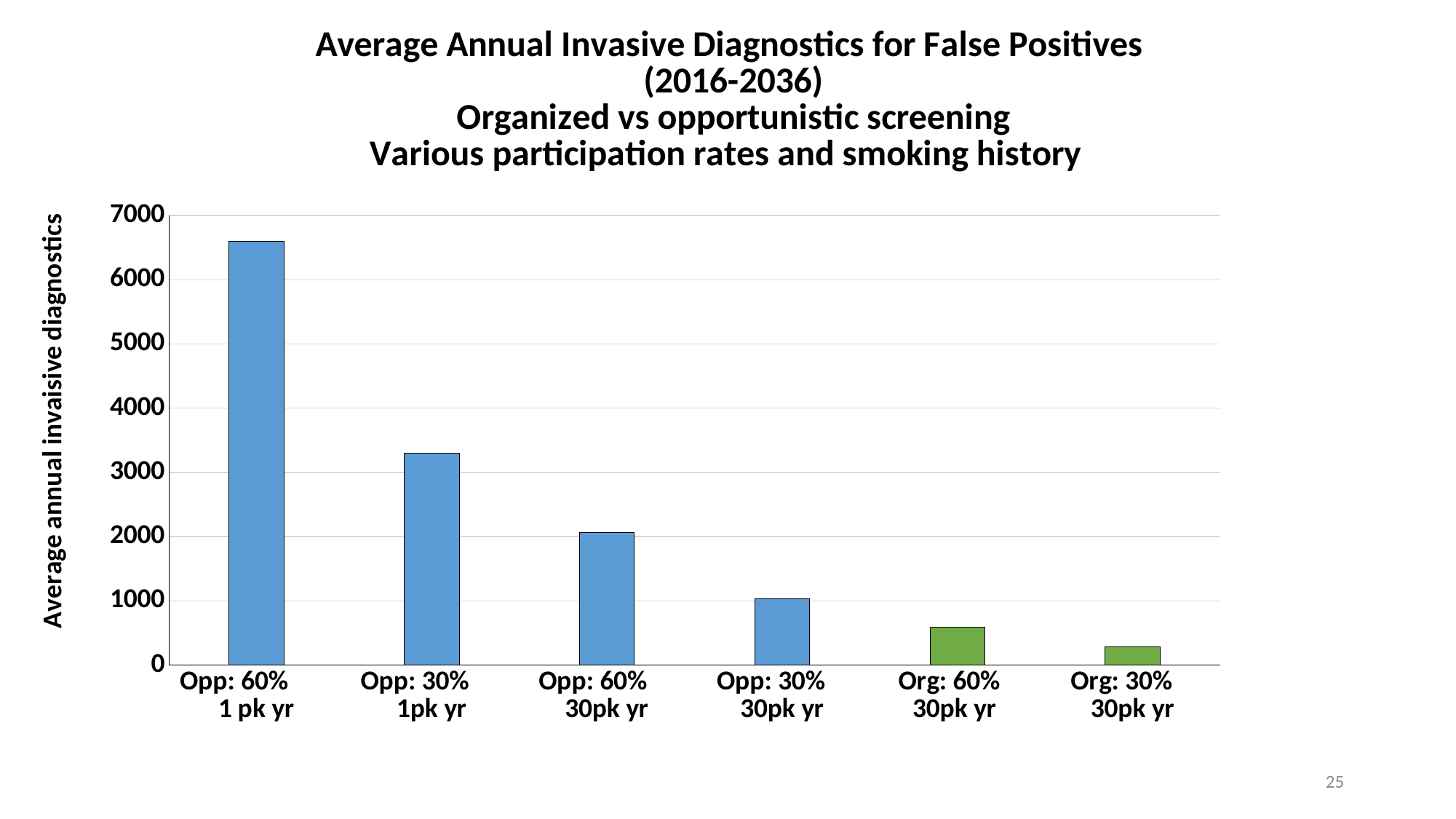
What kind of chart is shown on the slide? bar chart Is the value for Opp: 60% 1 pk yr greater or less than 6000? greater How many categories are plotted on the x axis? 6 What is the label of the vertical axis? Average annual invaisive diagnostics Do the values rise or fall moving from left to right along the x axis? fall Which category has the highest average annual invasive diagnostics? Opp: 60% 1 pk yr Is the value for Opp: 30% 1pk yr greater or less than 3000? greater What colour are the bars for the organized (Org) screening categories? green Which category has the lowest average annual invasive diagnostics? Org: 30% 30pk yr Is the value for Opp: 30% 30pk yr greater or less than 2000? less Which is larger, the value for Opp: 60% 30pk yr or the value for Org: 60% 30pk yr? Opp: 60% 30pk yr